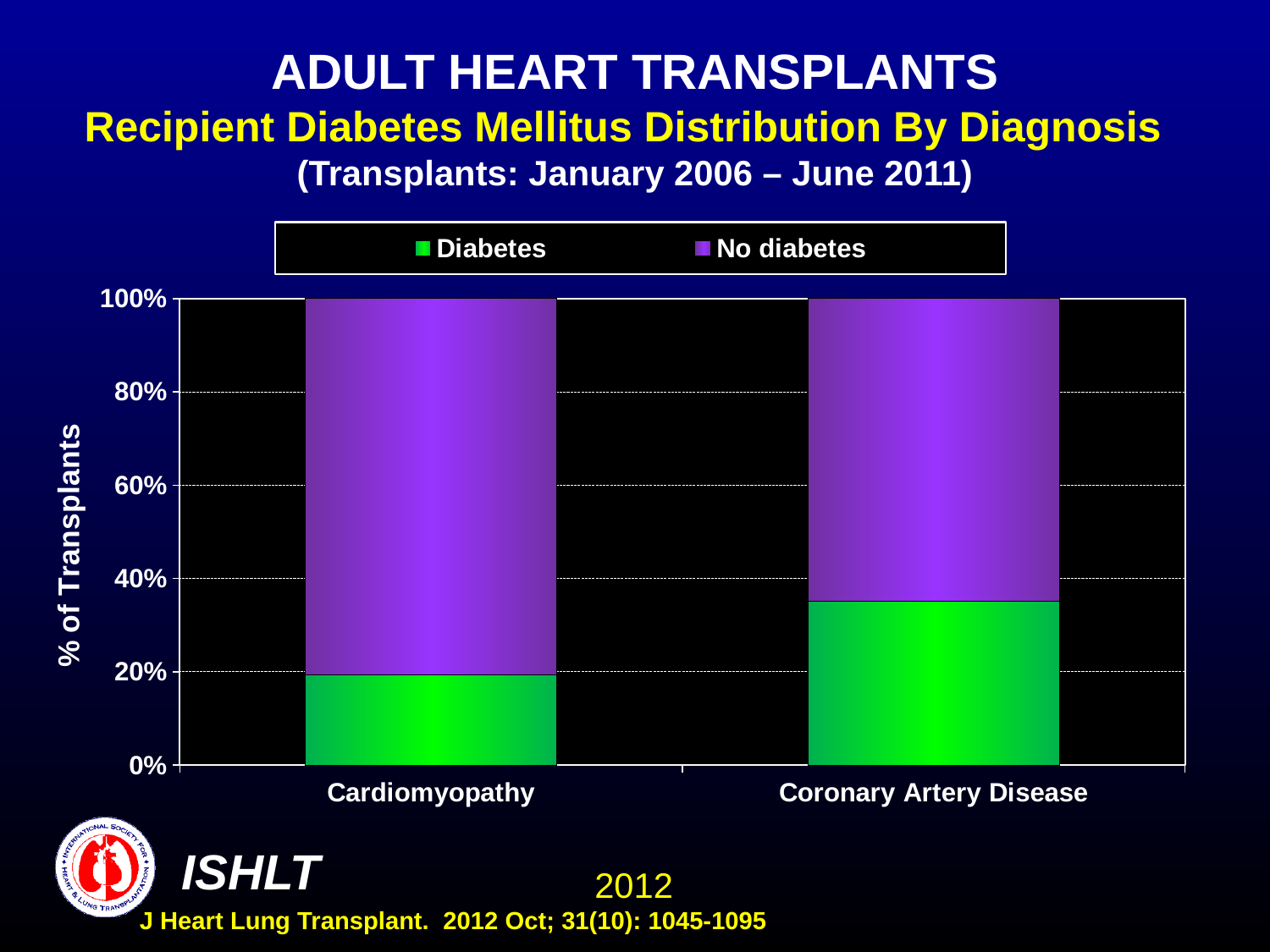
How many series does the legend list? 2 Which diagnosis category has the larger Diabetes share, Cardiomyopathy or Coronary Artery Disease? Coronary Artery Disease How many diagnosis categories are shown on the x axis? 2 Which colour represents the Diabetes series in the legend? green Is the No diabetes value for Cardiomyopathy greater or less than 60%? greater What kind of chart is shown on the slide? stacked bar chart Is the Diabetes value for Coronary Artery Disease greater or less than 40%? less Is the Diabetes value for Coronary Artery Disease greater or less than 20%? greater What is the label on the y axis? % of Transplants What is the total height of the stacked bar for Cardiomyopathy? 100% Which diagnosis category has the larger No diabetes share, Cardiomyopathy or Coronary Artery Disease? Cardiomyopathy